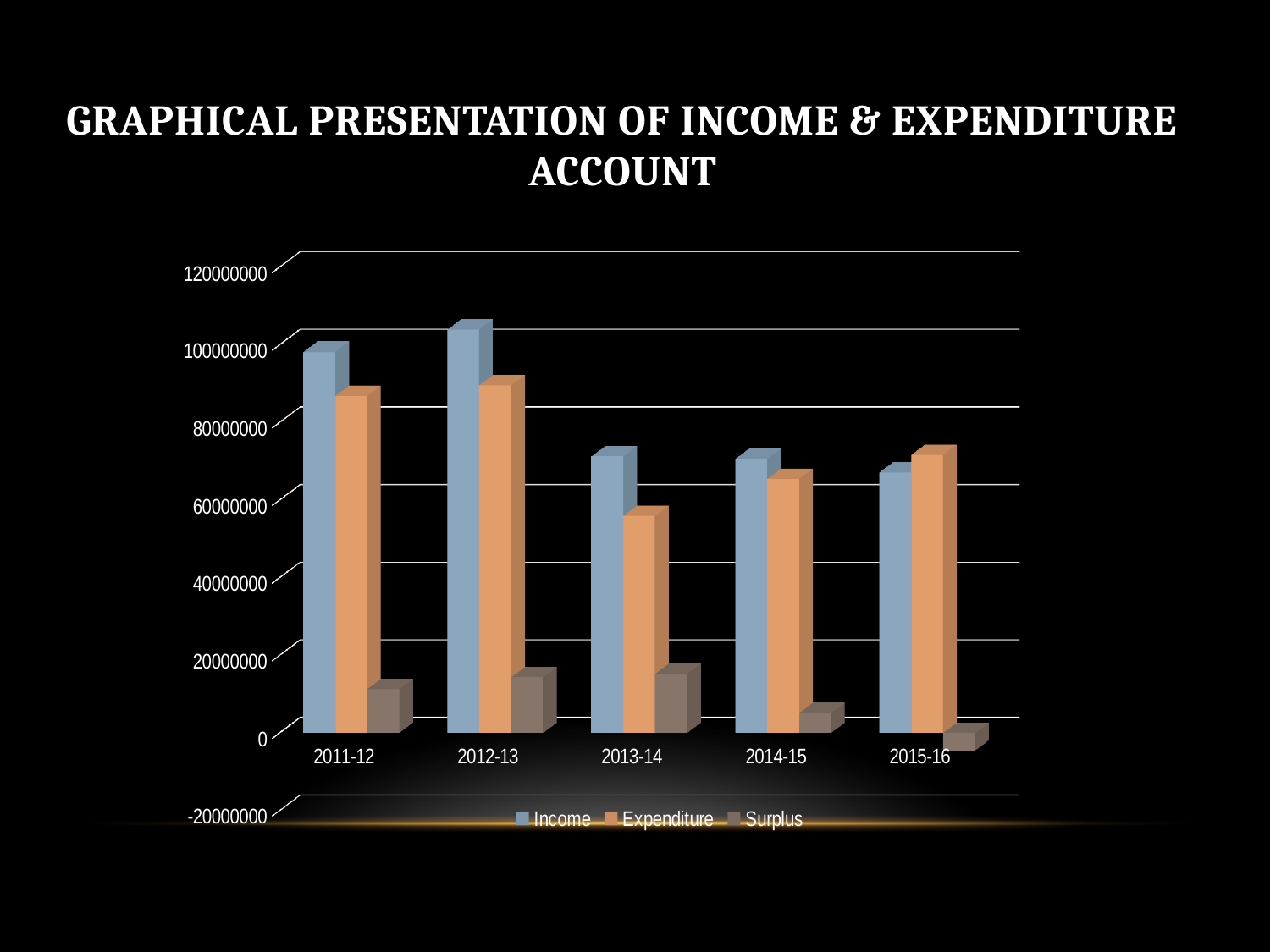
How many financial years are shown on the x axis? 5 In which year is Surplus the lowest? 2015-16 In 2015-16, which is larger, Income or Expenditure? Expenditure Is the Expenditure value for 2013-14 greater or less than 60000000? less In which year is Expenditure the lowest? 2013-14 How many series does the legend list? 3 Which series are listed in the legend? Income, Expenditure, Surplus Is the Income value for 2012-13 greater or less than 100000000? greater What kind of chart is shown on the slide? Bar chart In which year is Income the highest? 2012-13 What is the title of the chart slide? GRAPHICAL PRESENTATION OF INCOME & EXPENDITURE ACCOUNT Is the Surplus value for 2015-16 greater or less than 0? less